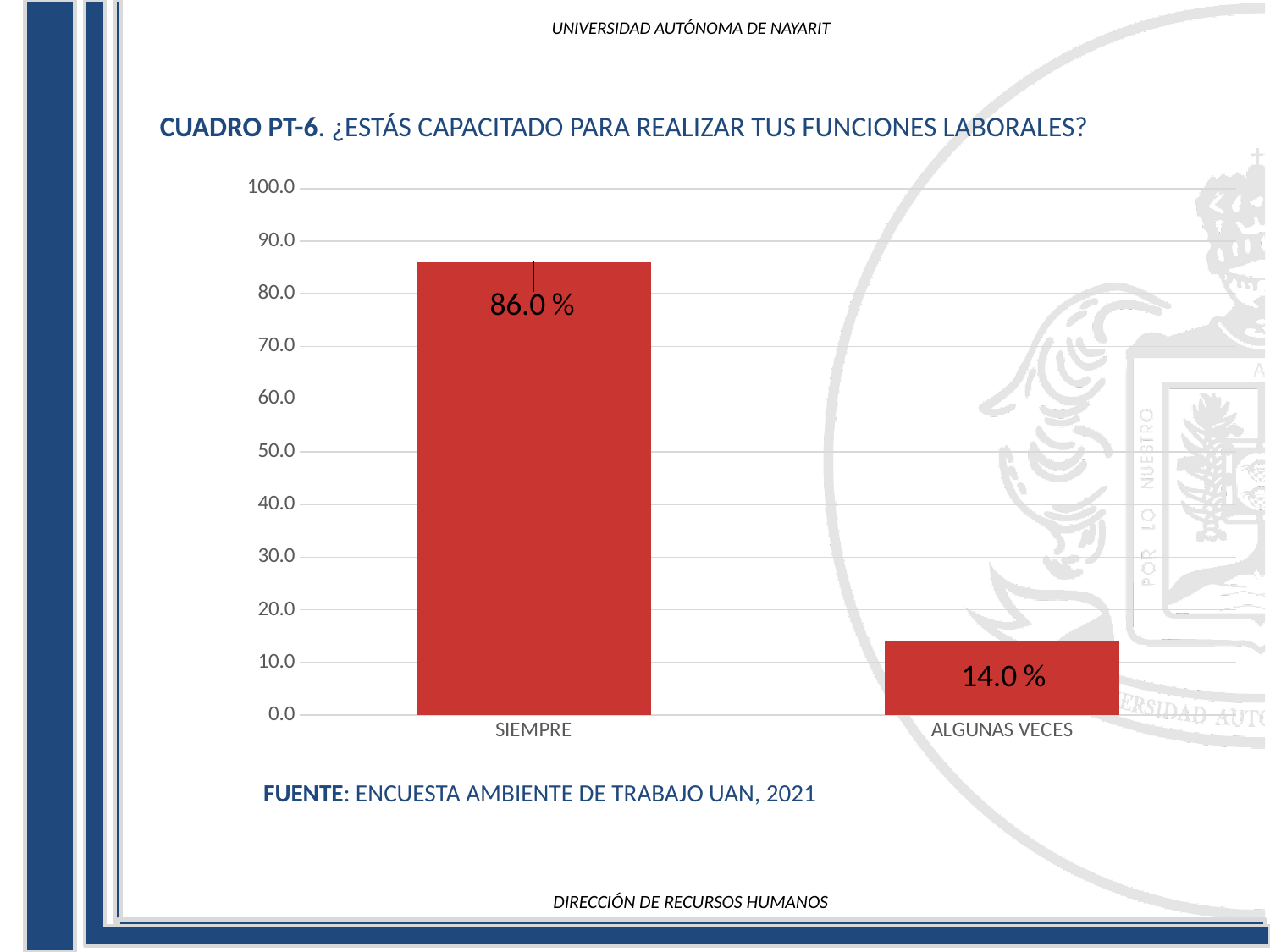
Which category has the highest value? SIEMPRE What is the difference between the values for SIEMPRE and ALGUNAS VECES? 72.0 % Which category has the lowest value? ALGUNAS VECES What is the source cited below the chart? ENCUESTA AMBIENTE DE TRABAJO UAN, 2021 Which is larger, the value for SIEMPRE or the value for ALGUNAS VECES? SIEMPRE What kind of chart is shown on the slide? Bar chart What is the value for ALGUNAS VECES? 14.0 % What is the title of the chart? CUADRO PT-6. ¿ESTÁS CAPACITADO PARA REALIZAR TUS FUNCIONES LABORALES? Is the value for SIEMPRE greater or less than 80.0? greater How many categories are shown on the x axis? 2 What is the value for SIEMPRE? 86.0 % Is the value for ALGUNAS VECES greater or less than 20.0? less